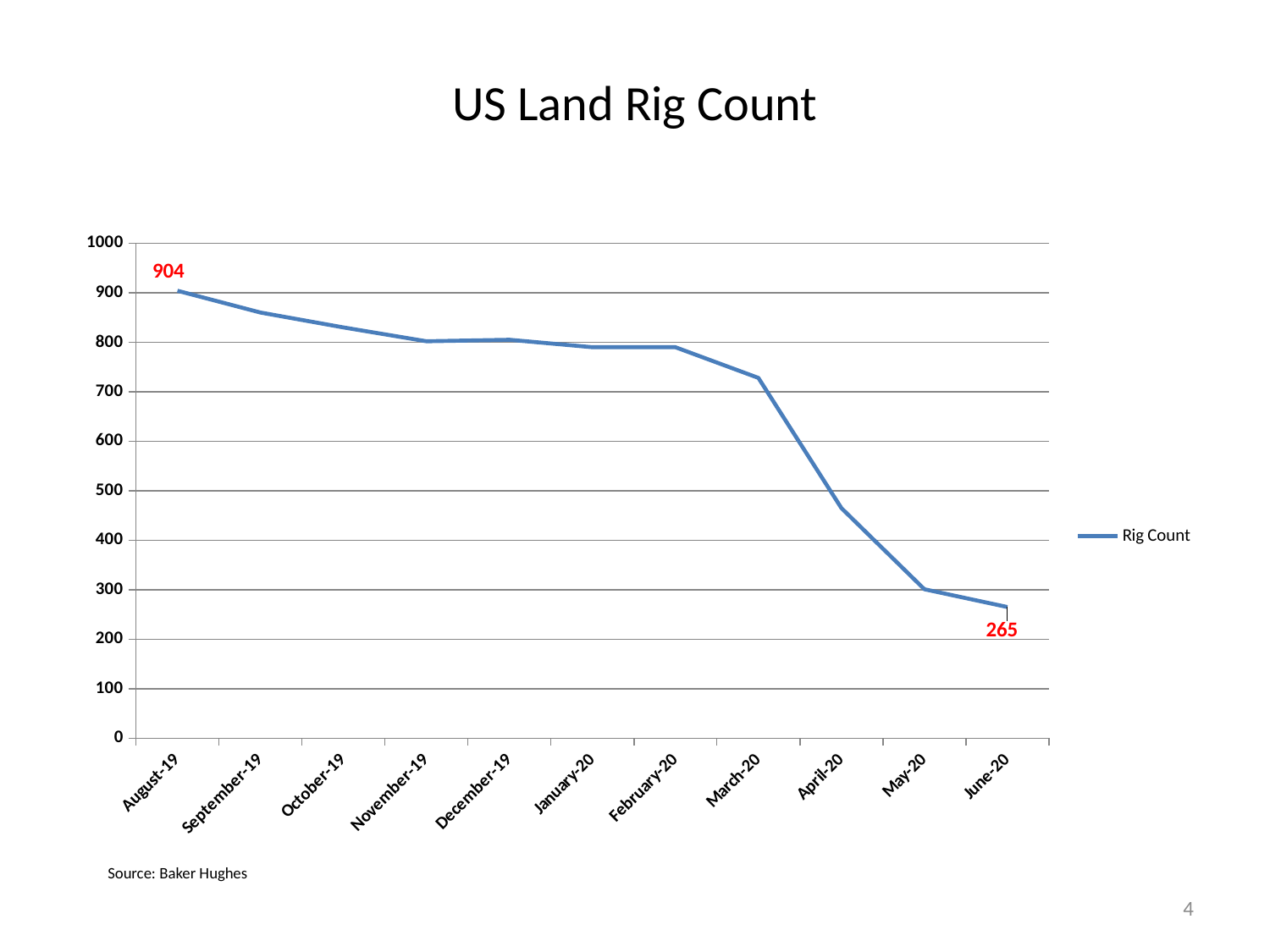
Which is larger, the rig count in March-20 or in April-20? March-20 What is the rig count for August-19? 904 Does the rig count rise or fall from August-19 to June-20? fall Which month has the highest rig count? August-19 Is the value for March-20 greater or less than 700? greater How many series does the legend list? 1 What is the rig count for June-20? 265 Is the value for April-20 greater or less than 500? less How many months are plotted on the x axis? 11 What kind of chart is shown? line chart What is the difference between the rig count in August-19 and June-20? 639 Which month has the lowest rig count? June-20